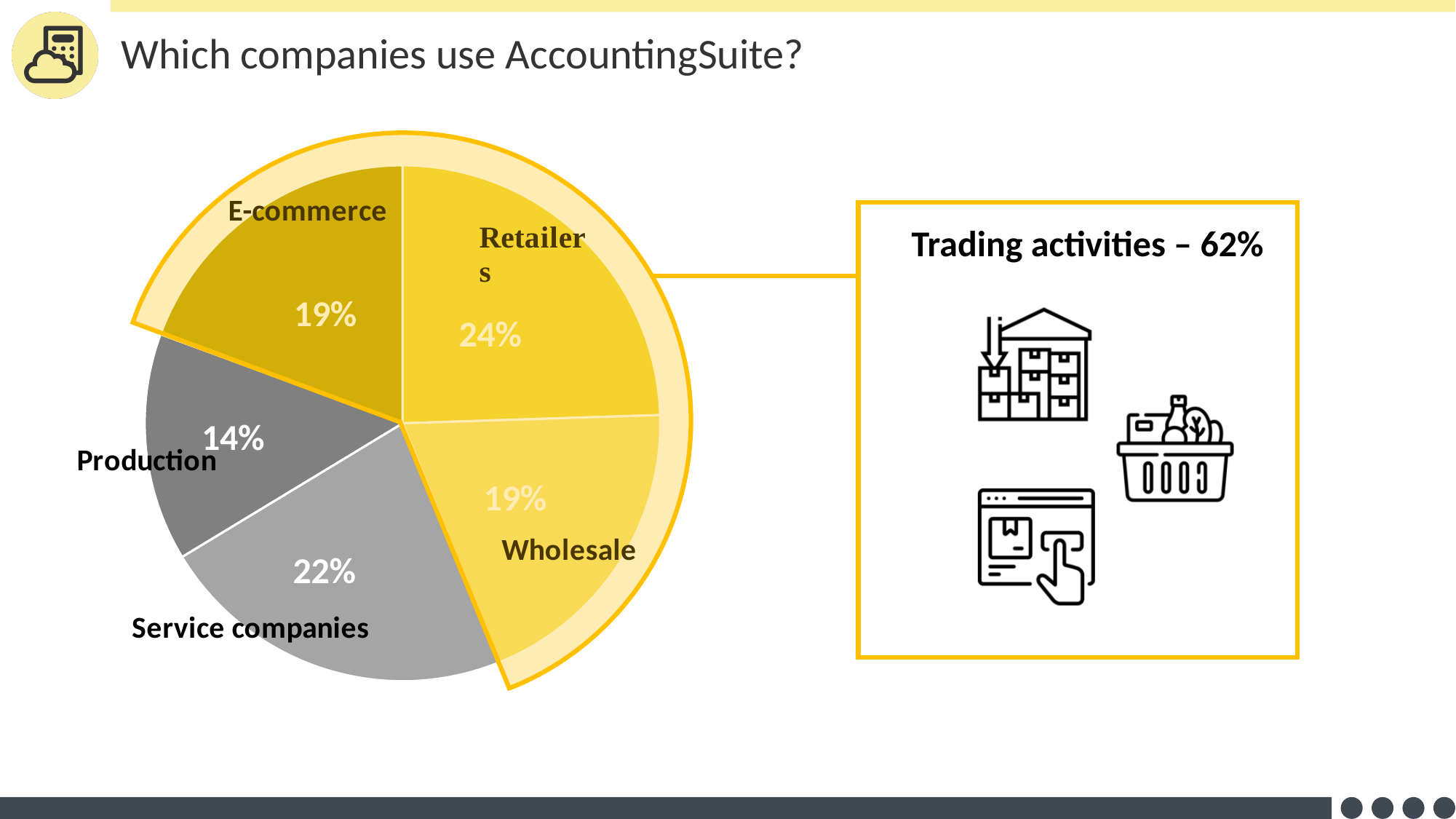
How many slices does the pie chart have? 5 What is the combined share of Retailers, Wholesale and E-commerce? 62% What percentage does the call-out box give for Trading activities? 62% What percentage of the pie is Retailers? 24% Which is larger, Service companies or E-commerce? Service companies Which category has the smallest slice of the pie? Production Which category has the largest slice of the pie? Retailers What percentage of the pie is Wholesale? 19% What percentage of the pie is Production? 14% What is the difference in percentage points between Retailers and Production? 10 What kind of chart is shown on the slide? pie chart What percentage of the pie is Service companies? 22%